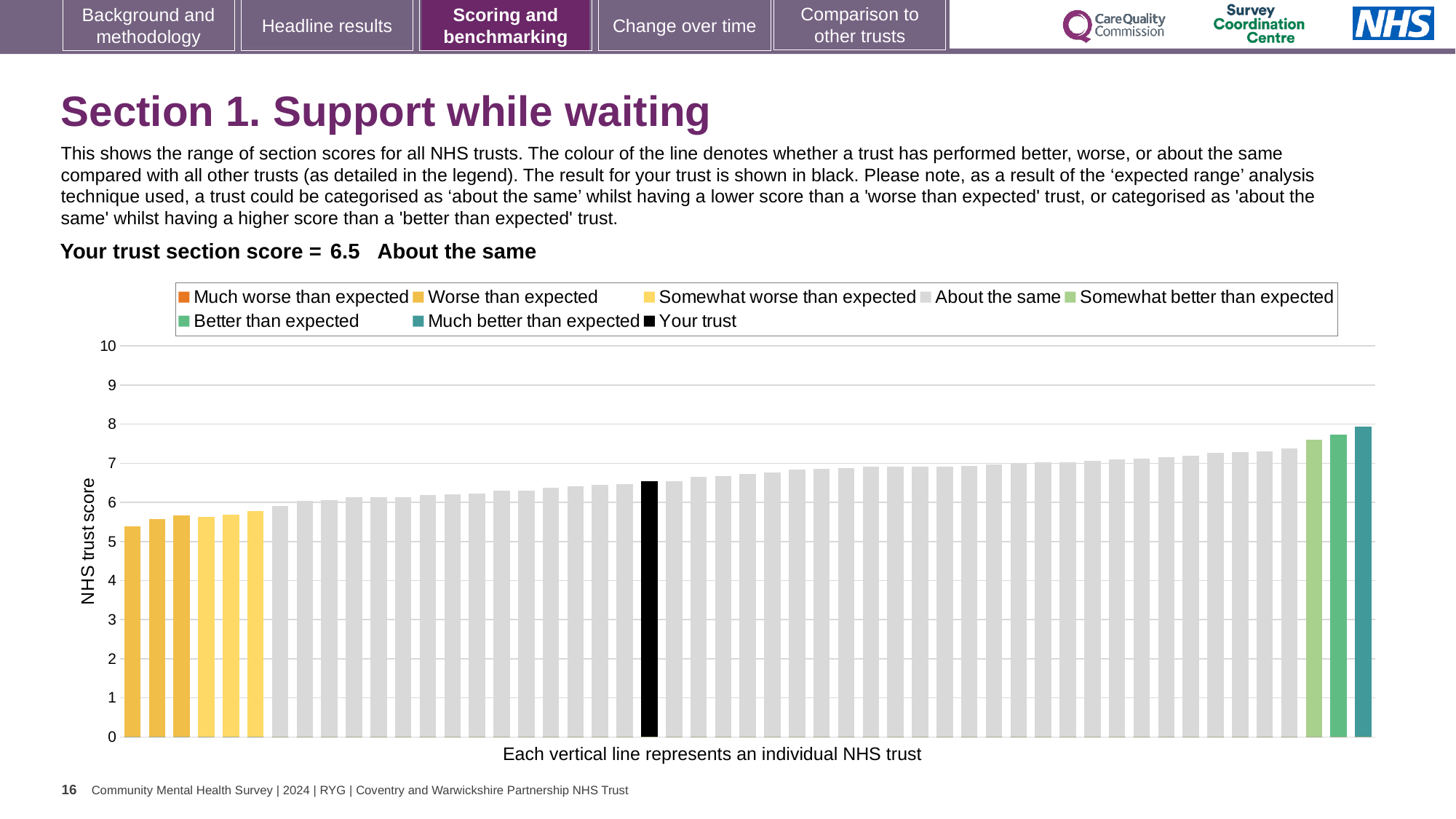
Is the value of the leftmost (lowest) bar greater or less than 5? greater Which legend category does the tallest bar on the chart belong to? Much better than expected Which performance category is your trust placed in for this section? About the same How many entries does the chart legend list? 8 Is the value of the tallest bar on the chart greater or less than 7? greater Which legend category do the lowest bars on the chart belong to? Worse than expected What kind of chart is shown on the slide? Bar chart What is the section score for your trust shown on the slide? 6.5 Is the value of the black 'Your trust' bar greater or less than 6? greater Do the bar values rise or fall from left to right along the x axis? Rise What is the label on the vertical axis of the chart? NHS trust score How many bars are coloured as 'Worse than expected' (yellow) on the chart? 3